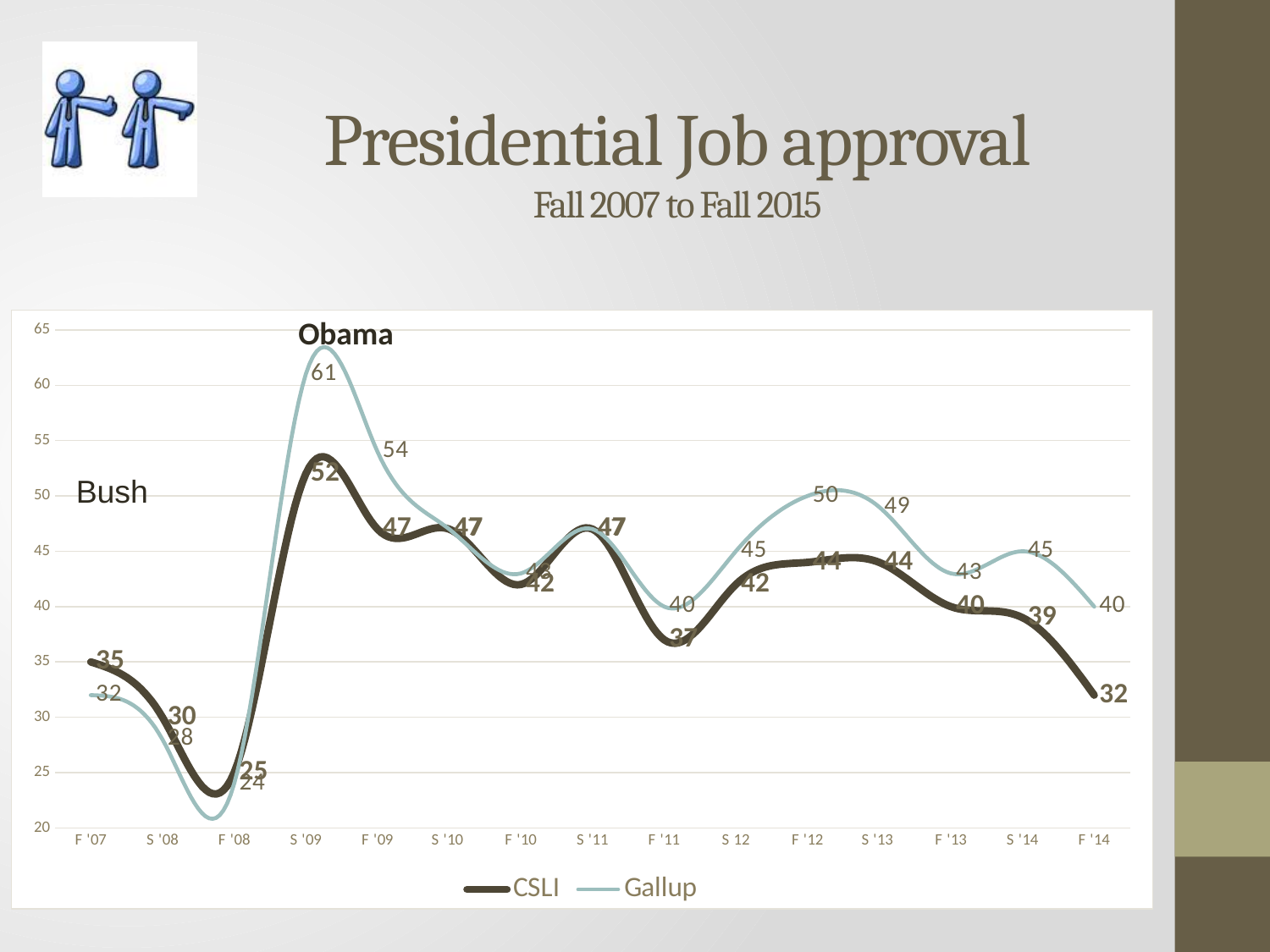
At which point on the x axis does the CSLI series reach its highest value? S '09 How many series does the legend list? 2 What is the Gallup value for S '09? 61 How many points are on the x axis? 15 What is the CSLI value for F '07? 35 What is the difference between the Gallup and CSLI values at S '09? 9 What is the CSLI value for F '14? 32 At F '12, which series has the larger value, CSLI or Gallup? Gallup Is the Gallup value at S '09 greater or less than 60? greater What kind of chart is shown on the slide? line chart At which point on the x axis does the Gallup series reach its lowest value? F '08 What is the difference between the Gallup and CSLI values at F '14? 8